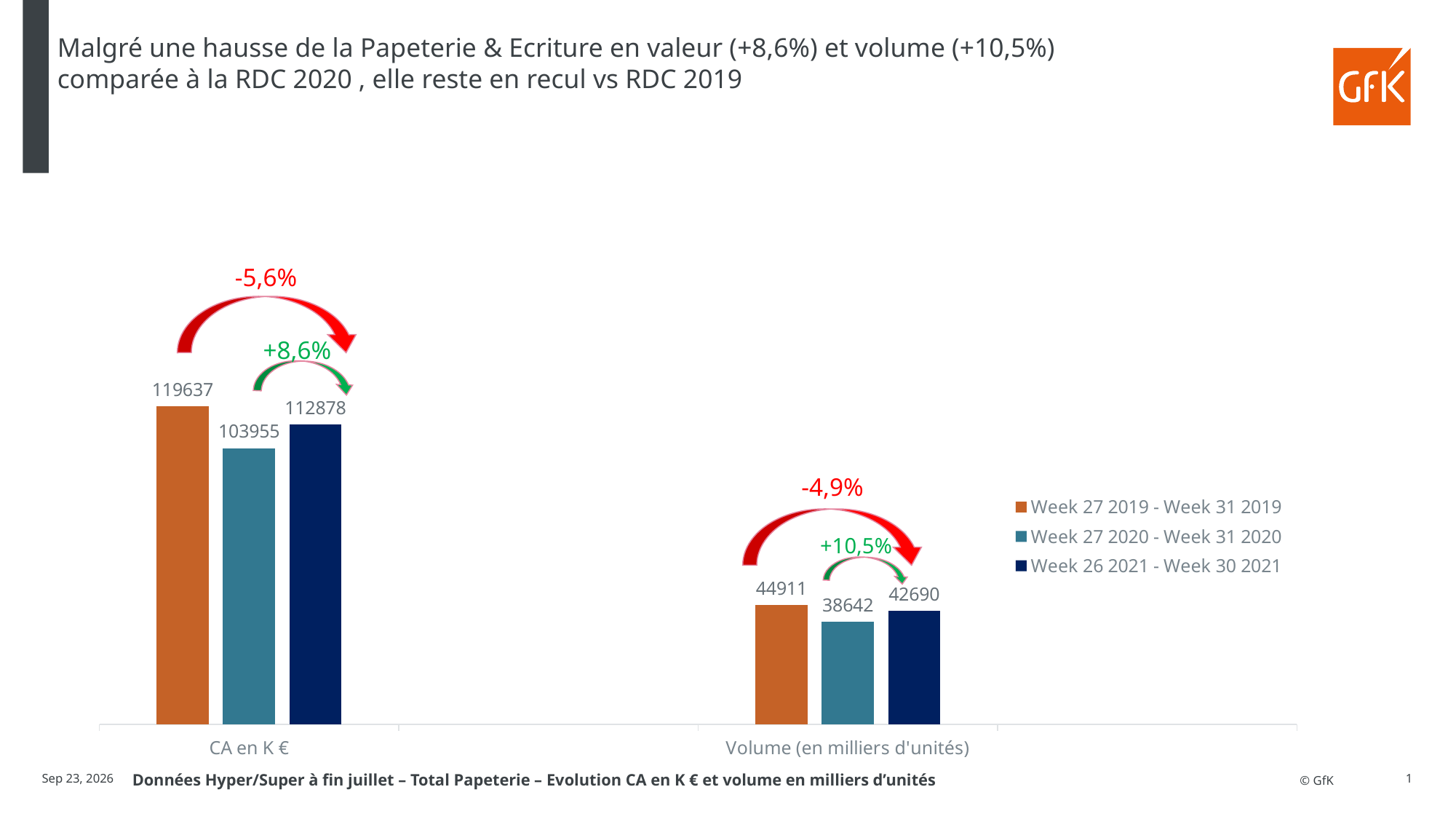
What is the value for Week 27 2020 - Week 31 2020 in the Volume (en milliers d'unités) category? 38642 What is the value for Week 27 2019 - Week 31 2019 in the CA en K € category? 119637 What is the difference between the Week 27 2019 - Week 31 2019 and Week 27 2020 - Week 31 2020 values in the Volume (en milliers d'unités) category? 6269 What is the value for Week 26 2021 - Week 30 2021 in the Volume (en milliers d'unités) category? 42690 What kind of chart is shown on the slide? Bar chart In the Volume (en milliers d'unités) category, which is larger: Week 27 2019 - Week 31 2019 or Week 26 2021 - Week 30 2021? Week 27 2019 - Week 31 2019 How many categories are shown on the x axis of the chart? 2 Which series has the lowest value in the Volume (en milliers d'unités) category? Week 27 2020 - Week 31 2020 What is the difference between the Week 27 2019 - Week 31 2019 and Week 26 2021 - Week 30 2021 values in the CA en K € category? 6759 Which series has the highest value in the CA en K € category? Week 27 2019 - Week 31 2019 What is the value for Week 27 2020 - Week 31 2020 in the CA en K € category? 103955 How many series does the legend list? 3